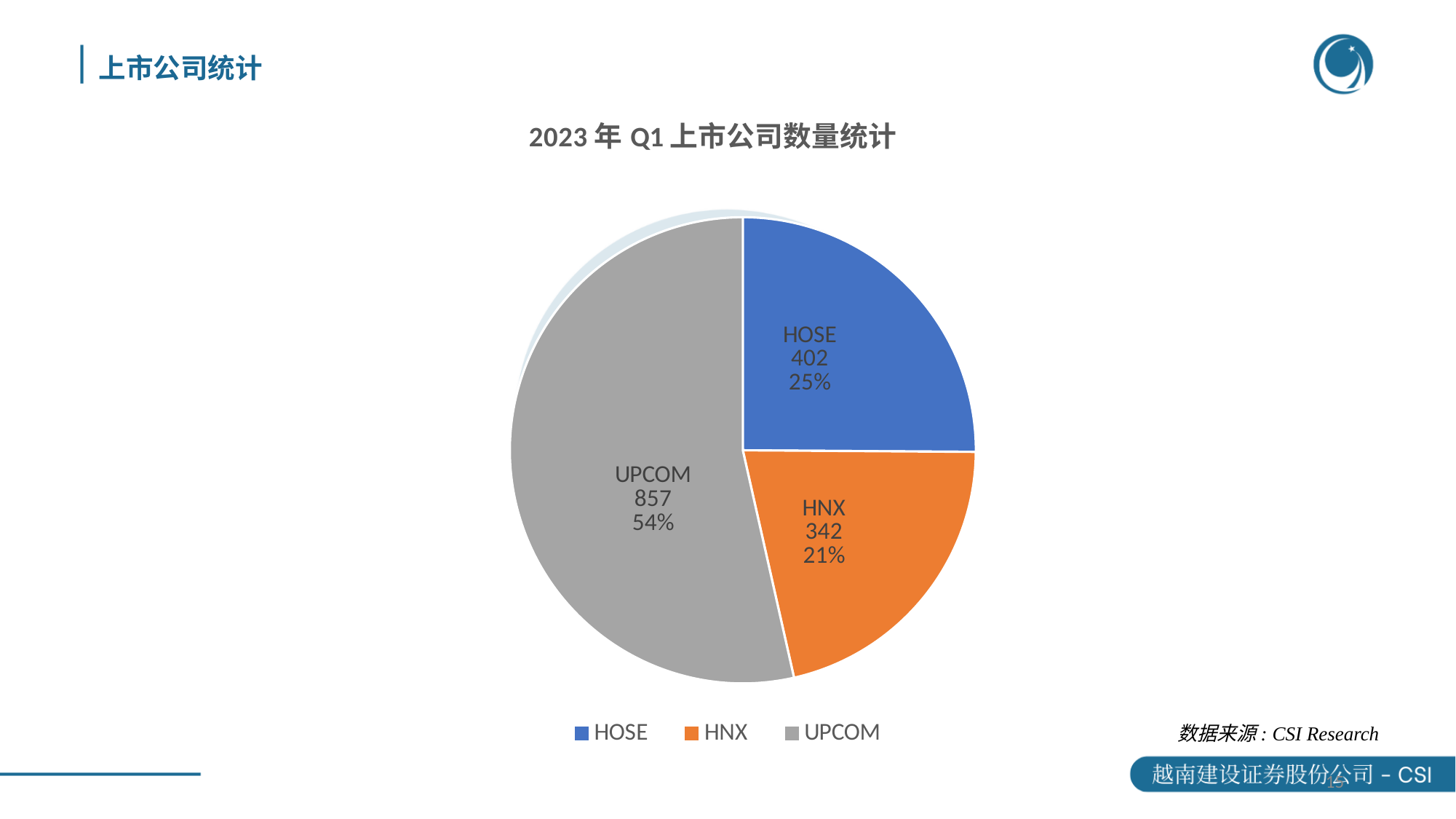
Which exchange has the largest number of listed companies? UPCOM What share of the pie does HNX represent? 21% Which has more listed companies, HOSE or HNX? HOSE How many listed companies does the chart show for HNX? 342 What is the difference between the number of listed companies on UPCOM and on HOSE? 455 Which exchange has the smallest number of listed companies? HNX What share of the pie does UPCOM represent? 54% What is the title of the chart? 2023 年 Q1 上市公司数量统计 How many slices does the pie chart have? 3 How many listed companies does the chart show for UPCOM? 857 What type of chart is shown on the slide? pie chart How many listed companies does the chart show for HOSE? 402